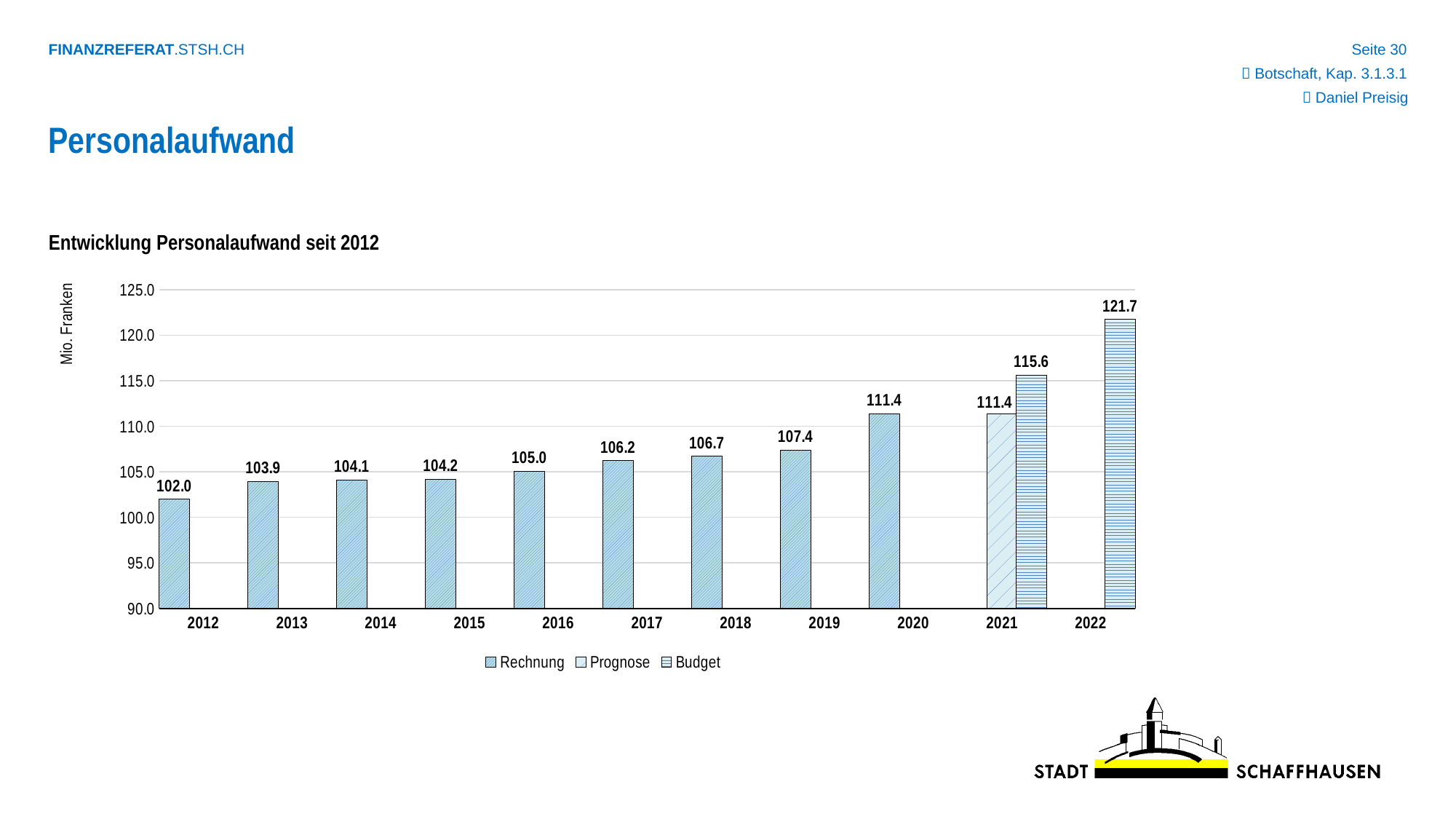
What is the difference between the Budget and the Prognose values for 2021? 4.2 Which year has the lowest value shown in the chart? 2012 How many series does the legend list? 3 What kind of chart is shown on the slide? Bar chart Which year has the highest value shown in the chart? 2022 What is the Rechnung value for 2012? 102.0 Do the Rechnung values rise or fall from 2012 to 2020? Rise Which is larger, the Rechnung value for 2017 or for 2018? 2018 What is the Budget value for 2022? 121.7 What is the Budget value for 2021? 115.6 What is the difference between the Rechnung values for 2020 and 2019? 4.0 What is the Prognose value for 2021? 111.4